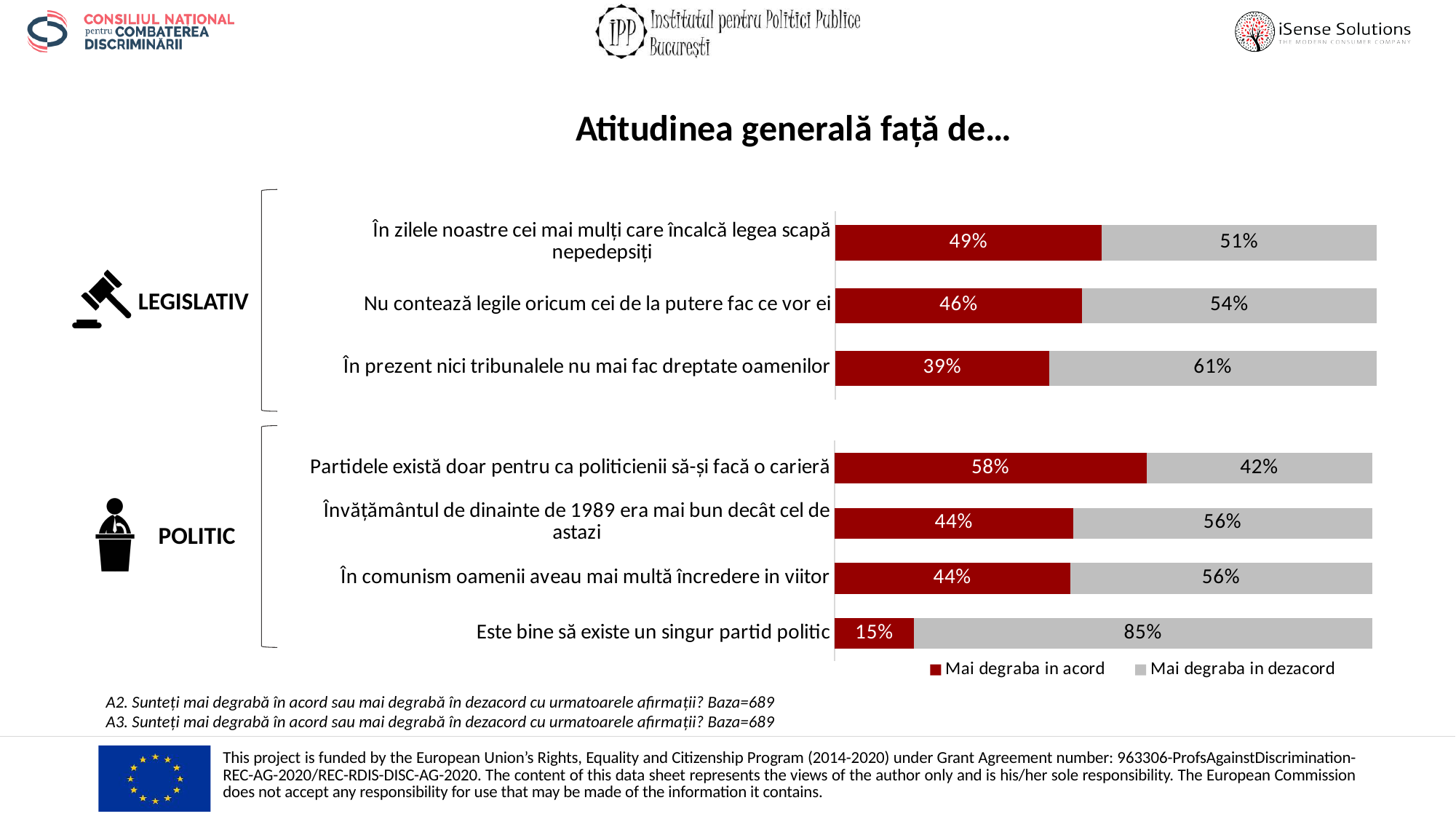
What is the difference between the 'Mai degraba in dezacord' and 'Mai degraba in acord' values for 'Este bine să existe un singur partid politic'? 70% Which is larger: the 'Mai degraba in acord' value for 'În zilele noastre cei mai mulți care încalcă legea scapă nepedepsiți' or for 'Nu contează legile oricum cei de la putere fac ce vor ei'? În zilele noastre cei mai mulți care încalcă legea scapă nepedepsiți What percentage of respondents are 'Mai degraba in acord' with the statement 'Este bine să existe un singur partid politic'? 15% How many series does the legend list? 2 What is the total of the two segments for 'Nu contează legile oricum cei de la putere fac ce vor ei'? 100% How many statements are shown in the chart? 7 Which colour represents 'Mai degraba in dezacord' in the chart? Grey What kind of chart is shown on the slide? Stacked bar chart What is the 'Mai degraba in acord' value for 'Partidele există doar pentru ca politicienii să-și facă o carieră'? 58% Which statement has the lowest 'Mai degraba in acord' share? Este bine să existe un singur partid politic Which statement has the highest 'Mai degraba in acord' share? Partidele există doar pentru ca politicienii să-și facă o carieră What is the 'Mai degraba in dezacord' value for 'În prezent nici tribunalele nu mai fac dreptate oamenilor'? 61%